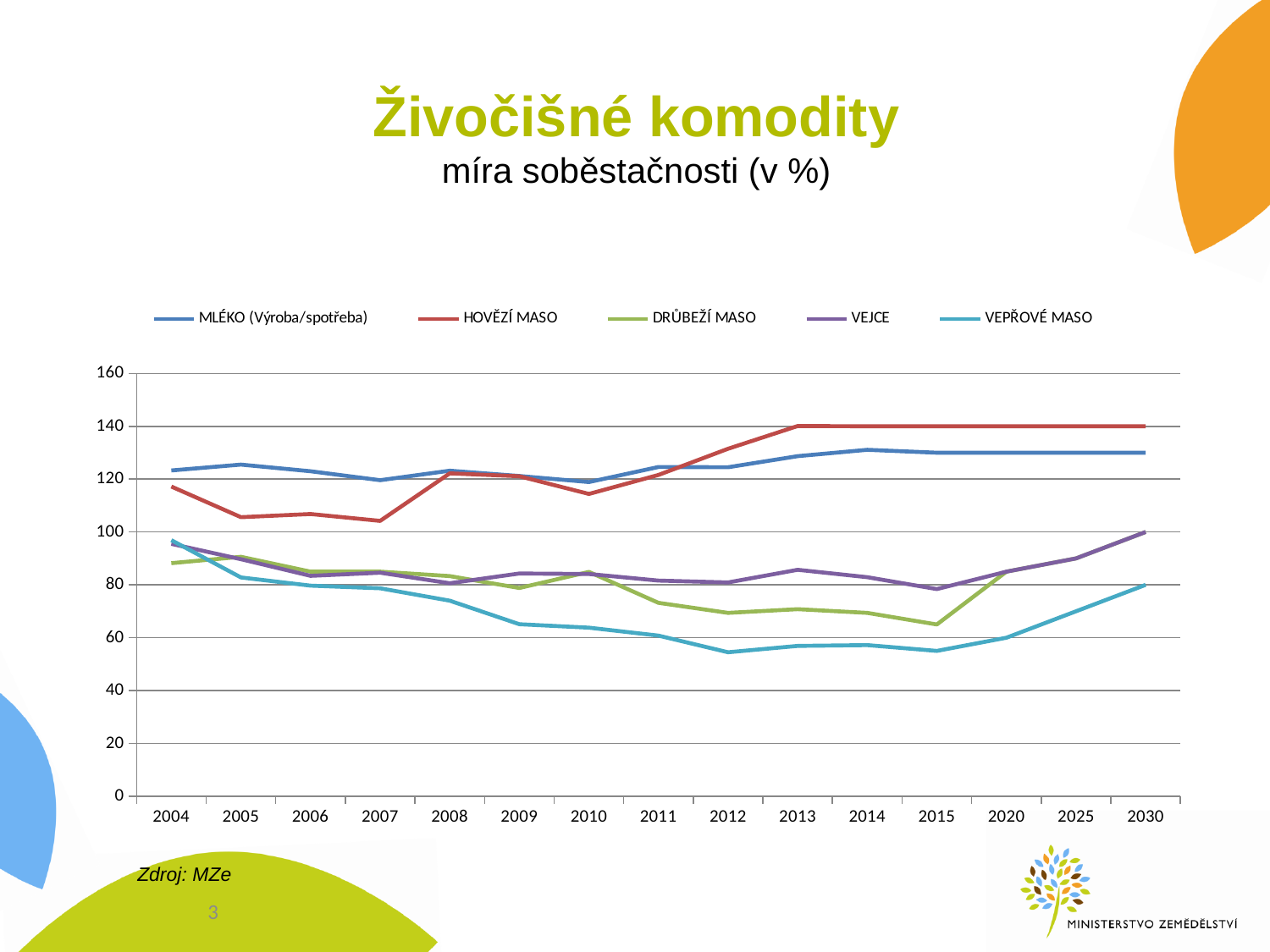
Is the value for VEPŘOVÉ MASO in 2012 greater or less than 60? less What is the value for HOVĚZÍ MASO in 2020? 140 How many years are shown on the x axis? 15 Is the value for MLÉKO (Výroba/spotřeba) in 2004 greater or less than 120? greater Which series has the highest value in 2004? MLÉKO (Výroba/spotřeba) What kind of chart is shown on the slide? line chart Does the VEPŘOVÉ MASO line rise or fall from 2004 to 2012? fall Which is larger in 2004, HOVĚZÍ MASO or DRŮBEŽÍ MASO? HOVĚZÍ MASO Which series has the highest value in 2030? HOVĚZÍ MASO What is the title of the chart slide? Živočišné komodity How many series does the legend list? 5 Which series has the lowest value in 2012? VEPŘOVÉ MASO